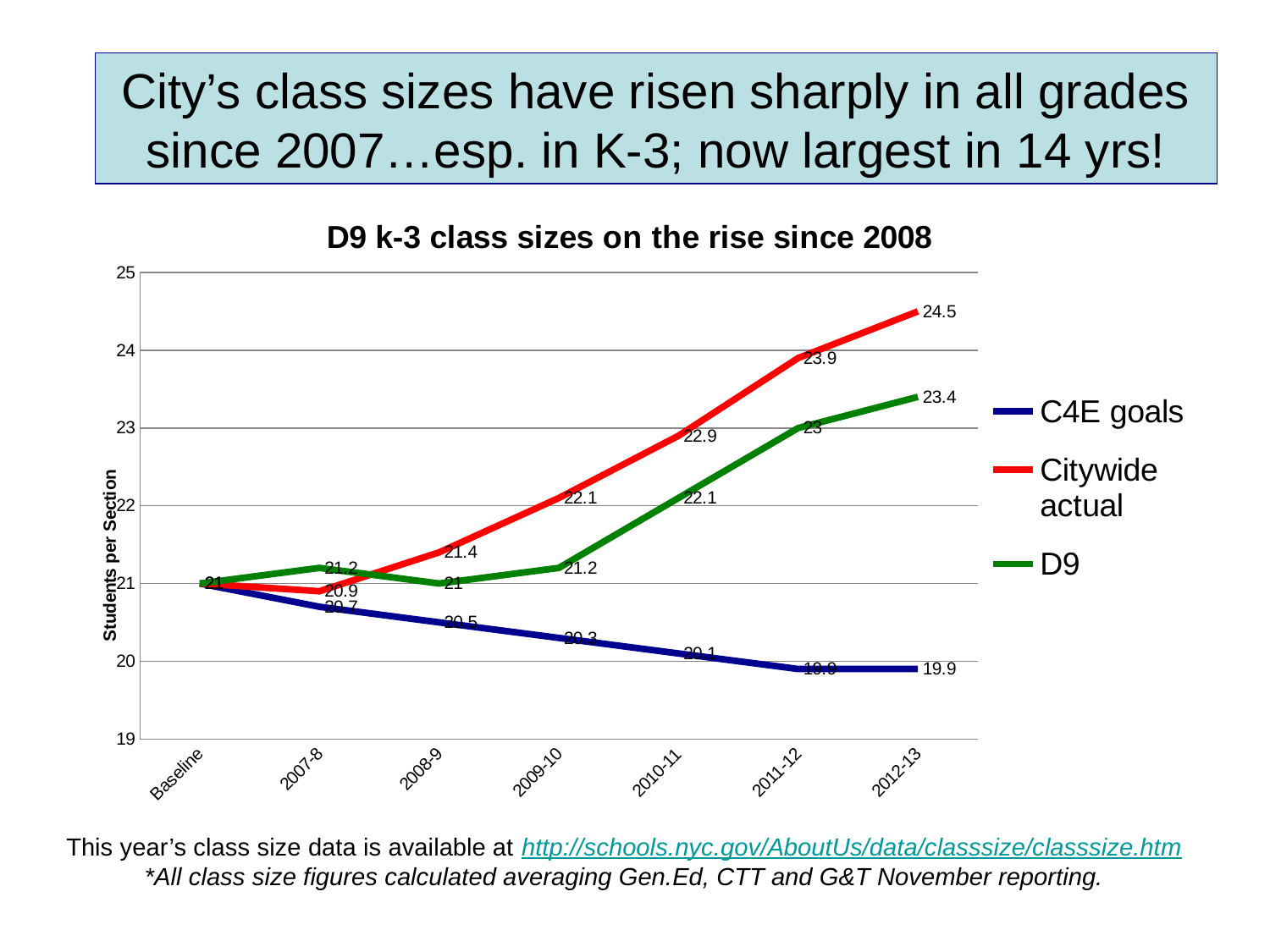
How many points are plotted along the x axis for each series? 7 What is the difference between the Citywide actual and D9 values in 2012-13? 1.1 Is the C4E goals value for 2009-10 greater or less than 21? less How many series does the legend list? 3 What is the Citywide actual value for 2012-13? 24.5 What is the Citywide actual value for 2011-12? 23.9 What is the D9 value for 2012-13? 23.4 In which year does the Citywide actual series reach its highest value? 2012-13 Does the C4E goals series rise or fall from Baseline to 2012-13? fall In 2010-11, which is larger: the Citywide actual value or the D9 value? Citywide actual What kind of chart is shown on the slide? line chart What is the C4E goals value for 2012-13? 19.9